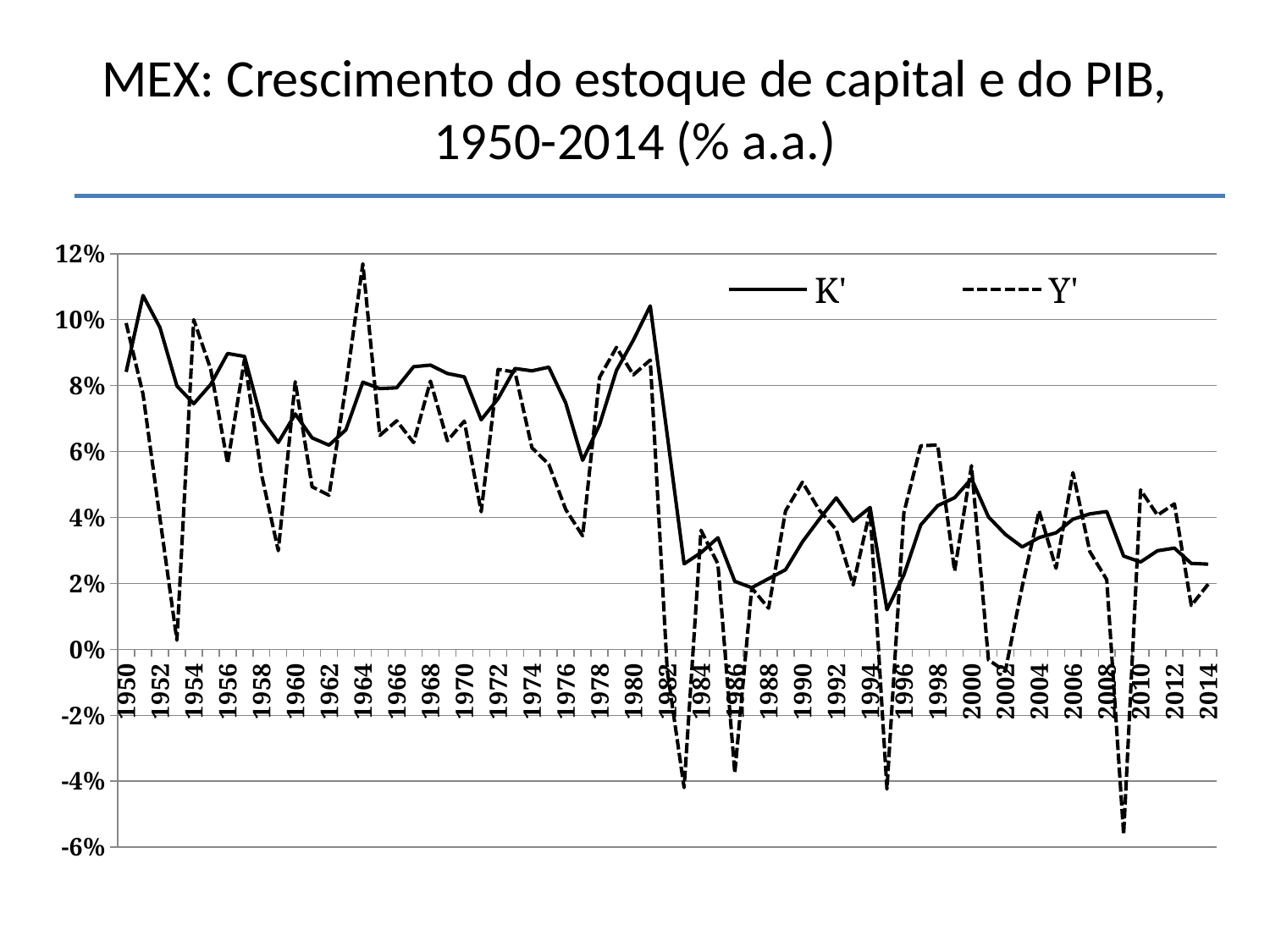
In 1995, which series has the larger value, K' or Y'? K' What kind of chart is shown on the slide? Line chart In which year does the K' series reach its lowest value? 1995 In which year does the Y' series reach its lowest value? 2009 Is the value of K' in 1995 greater or less than 2%? less In which year does the Y' series reach its highest value? 1964 Which series is drawn with a dashed line? Y' How many series does the legend list? 2 Does the K' series rise or fall between 1981 and 1983? Fall Is the value of Y' in 1964 greater or less than 10%? greater What are the two series named in the legend? K' and Y' Is the value of Y' in 2009 greater or less than -4%? less